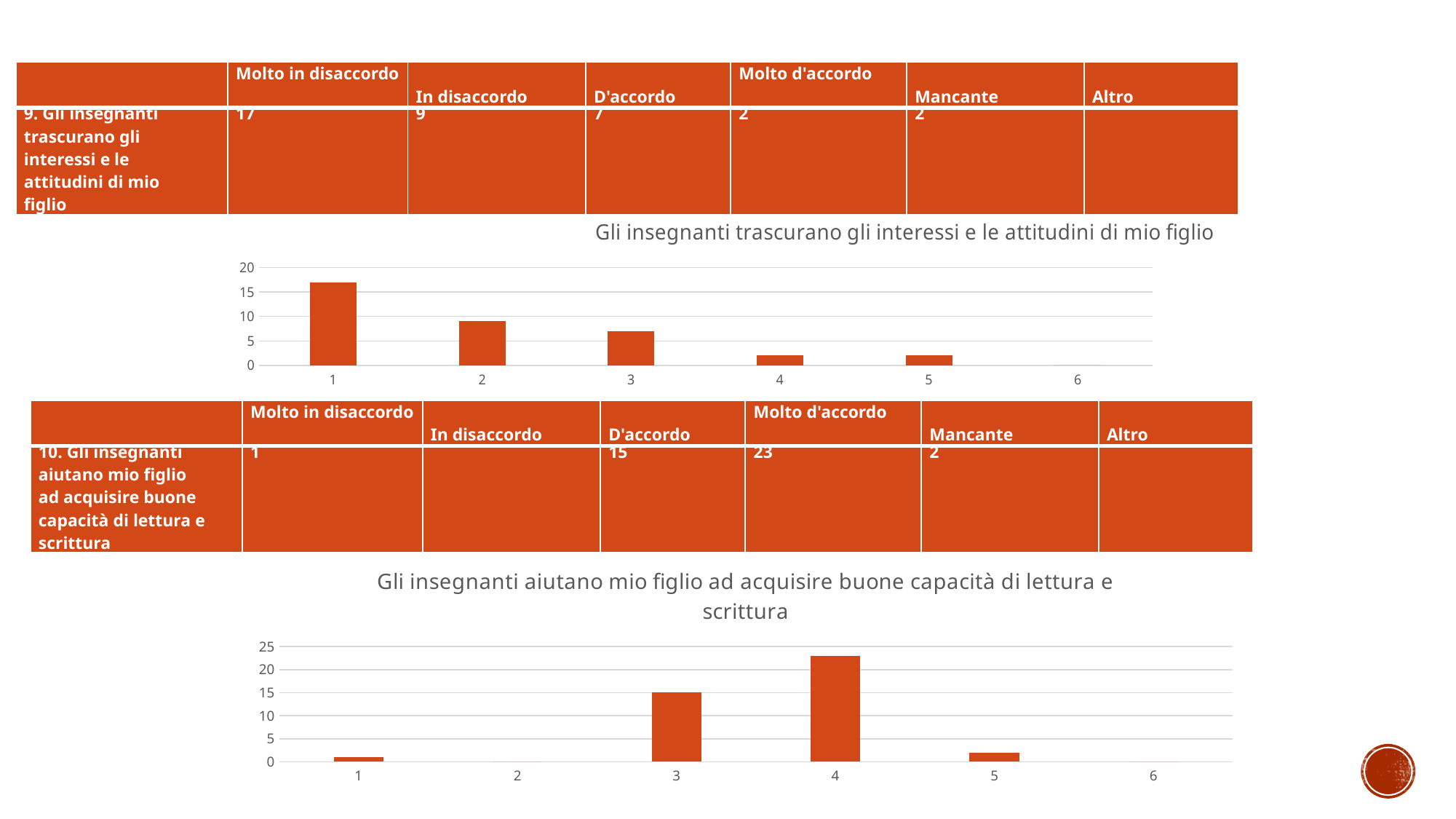
In the chart titled "Gli insegnanti aiutano mio figlio ad acquisire buone capacità di lettura e scrittura", which category has the highest bar? 4 In the chart titled "Gli insegnanti trascurano gli interessi e le attitudini di mio figlio", what is the value for category 1? 17 In the chart titled "Gli insegnanti trascurano gli interessi e le attitudini di mio figlio", how many categories are shown on the x axis? 6 In the chart titled "Gli insegnanti aiutano mio figlio ad acquisire buone capacità di lettura e scrittura", what is the value for category 3? 15 In the chart titled "Gli insegnanti aiutano mio figlio ad acquisire buone capacità di lettura e scrittura", what is the value for category 4? 23 In the chart titled "Gli insegnanti trascurano gli interessi e le attitudini di mio figlio", which category has the highest bar? 1 In the chart titled "Gli insegnanti aiutano mio figlio ad acquisire buone capacità di lettura e scrittura", which is larger, the value for category 3 or category 4? category 4 In the chart titled "Gli insegnanti trascurano gli interessi e le attitudini di mio figlio", what is the difference between the values for category 1 and category 2? 8 In the chart titled "Gli insegnanti trascurano gli interessi e le attitudini di mio figlio", is the value for category 3 greater or less than 10? less In the chart titled "Gli insegnanti aiutano mio figlio ad acquisire buone capacità di lettura e scrittura", what is the difference between the values for category 4 and category 3? 8 In the chart titled "Gli insegnanti aiutano mio figlio ad acquisire buone capacità di lettura e scrittura", is the value for category 4 greater or less than 20? greater What kind of chart is the top chart on the slide? bar chart